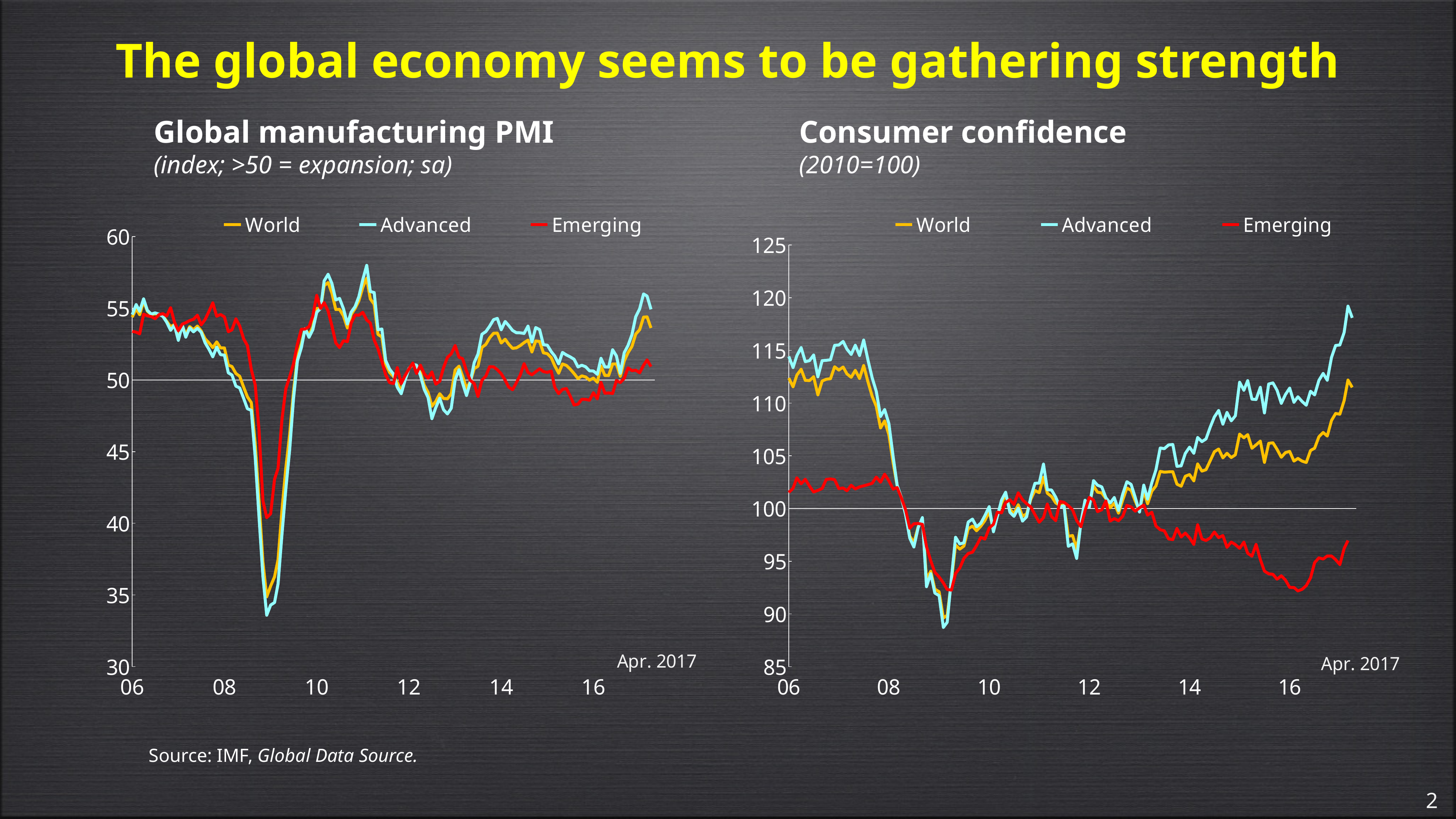
How many series does the legend of the Global manufacturing PMI chart list? 3 In the Global manufacturing PMI chart, is the Emerging value at Apr. 2017 greater or less than 50? greater In the Consumer confidence chart, is the Advanced value at Apr. 2017 greater or less than 115? greater What kind of chart is the Global manufacturing PMI chart? line chart How many series does the legend of the Consumer confidence chart list? 3 In the Consumer confidence chart, is the Emerging value at Apr. 2017 greater or less than 100? less What base period is given in the subtitle of the Consumer confidence chart? 2010=100 In the Global manufacturing PMI chart, which series is higher at Apr. 2017, Advanced or Emerging? Advanced What kind of chart is the Consumer confidence chart? line chart In the Consumer confidence chart, does the Advanced series rise or fall between 2013 and Apr. 2017? rise In the Consumer confidence chart, which series is higher at Apr. 2017, Advanced or Emerging? Advanced